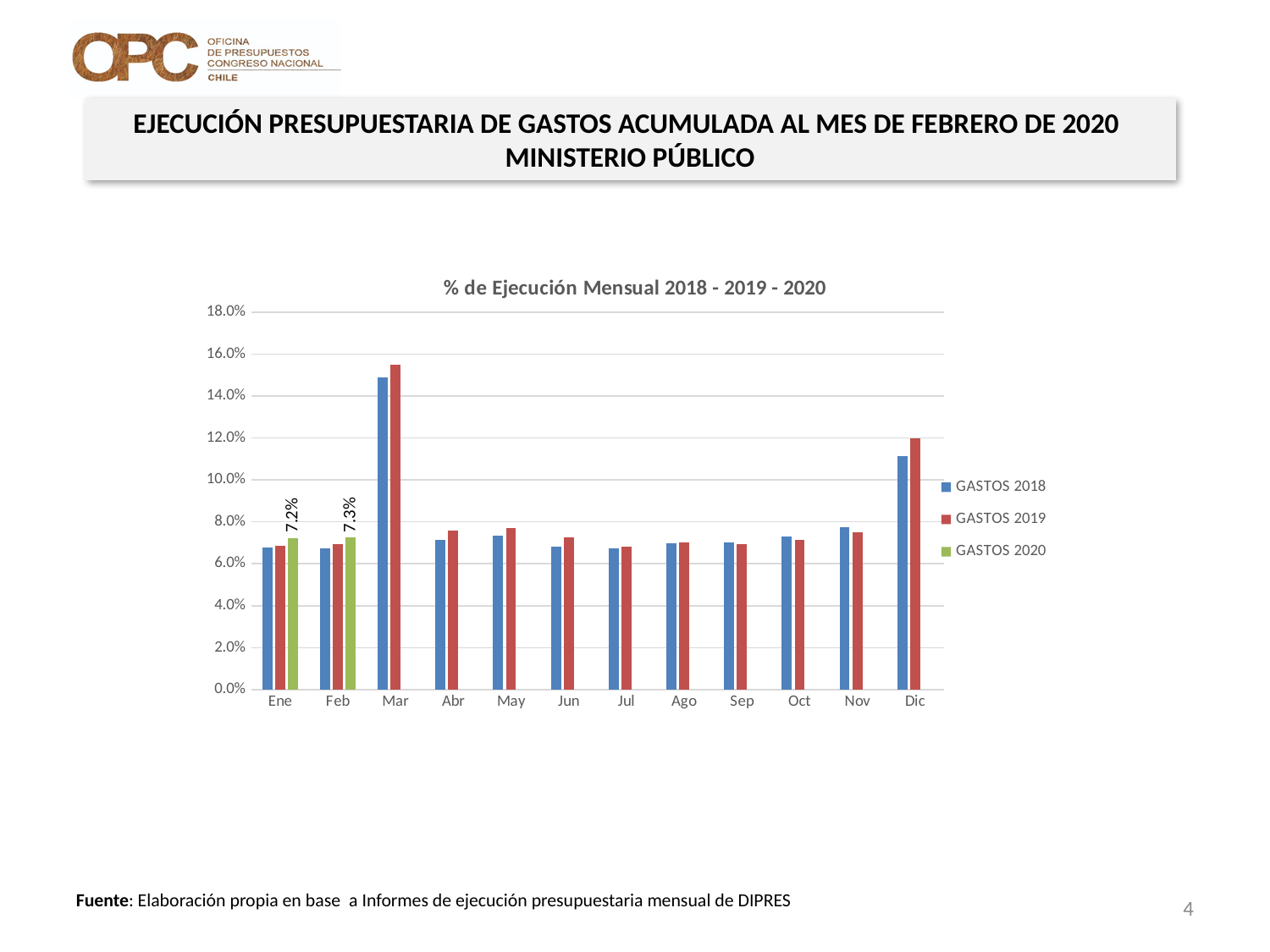
How many series does the legend list? 3 What is the title of the chart? % de Ejecución Mensual 2018 - 2019 - 2020 What is the value for GASTOS 2020 in Feb? 7.3% What is the value for GASTOS 2020 in Ene? 7.2% In which month is the GASTOS 2019 value highest? Mar In which month is the GASTOS 2018 value highest? Mar Is the value for GASTOS 2019 in Mar greater or less than 14.0%? greater How many months are shown on the x axis? 12 What is the difference between the GASTOS 2020 values for Feb and Ene? 0.1% What kind of chart is shown on the slide? Bar chart Which series has the larger value in Mar, GASTOS 2018 or GASTOS 2019? GASTOS 2019 Is the value for GASTOS 2018 in Dic greater or less than 10.0%? greater